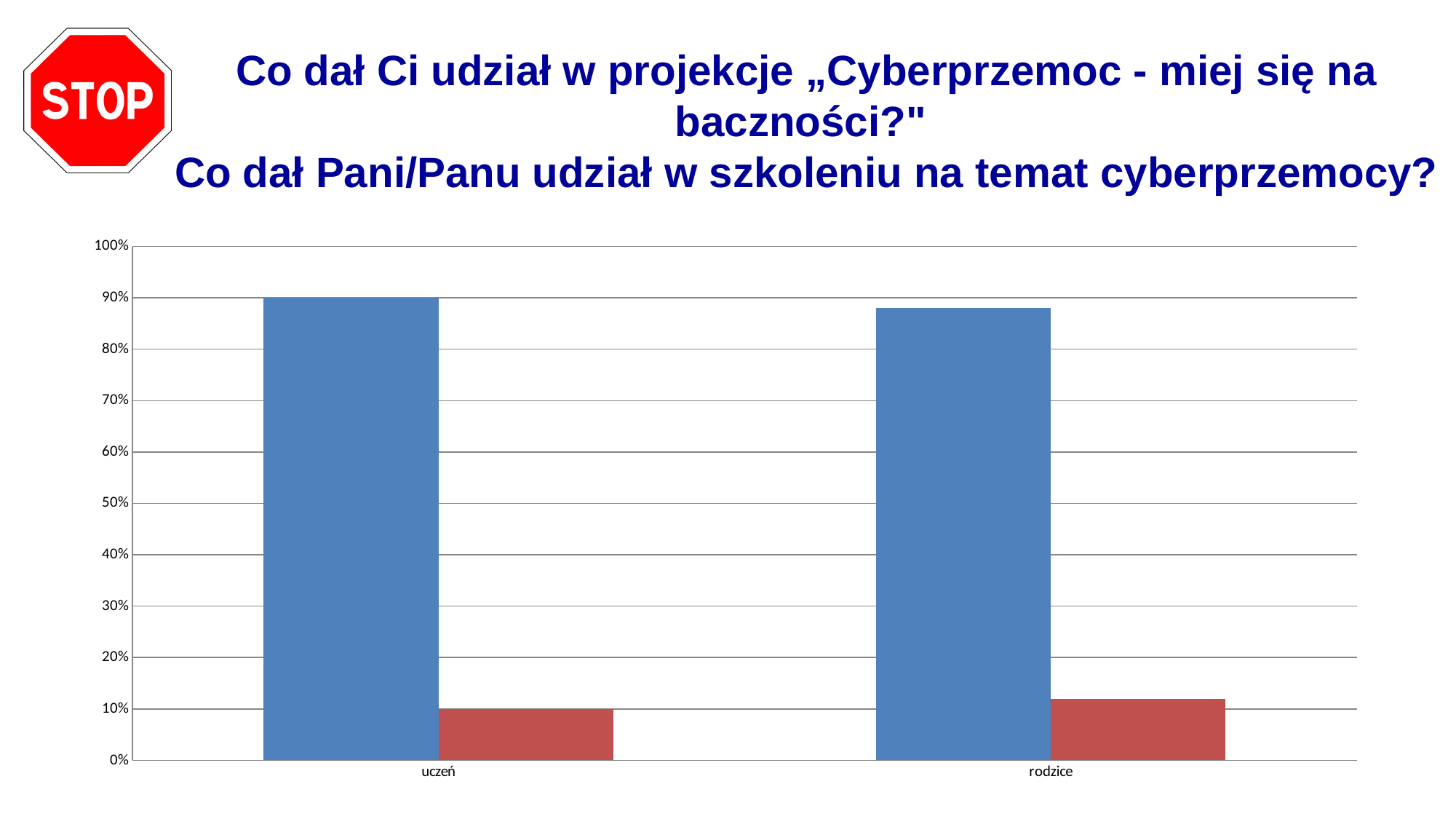
Which category has the lowest red bar? uczeń What is the value of the blue bar for uczeń? 90% Is the value of the red bar for rodzice greater or less than 20%? less Which is larger for uczeń, the blue bar or the red bar? the blue bar What is the difference between the blue bar and the red bar for uczeń? 80% Which category has the highest blue bar? uczeń What kind of chart is shown on the slide? bar chart Is the value of the blue bar for rodzice greater or less than 80%? greater Is the value of the red bar for rodzice greater or less than 10%? greater What is the value of the red bar for uczeń? 10% How many categories are shown on the x axis of the chart? 2